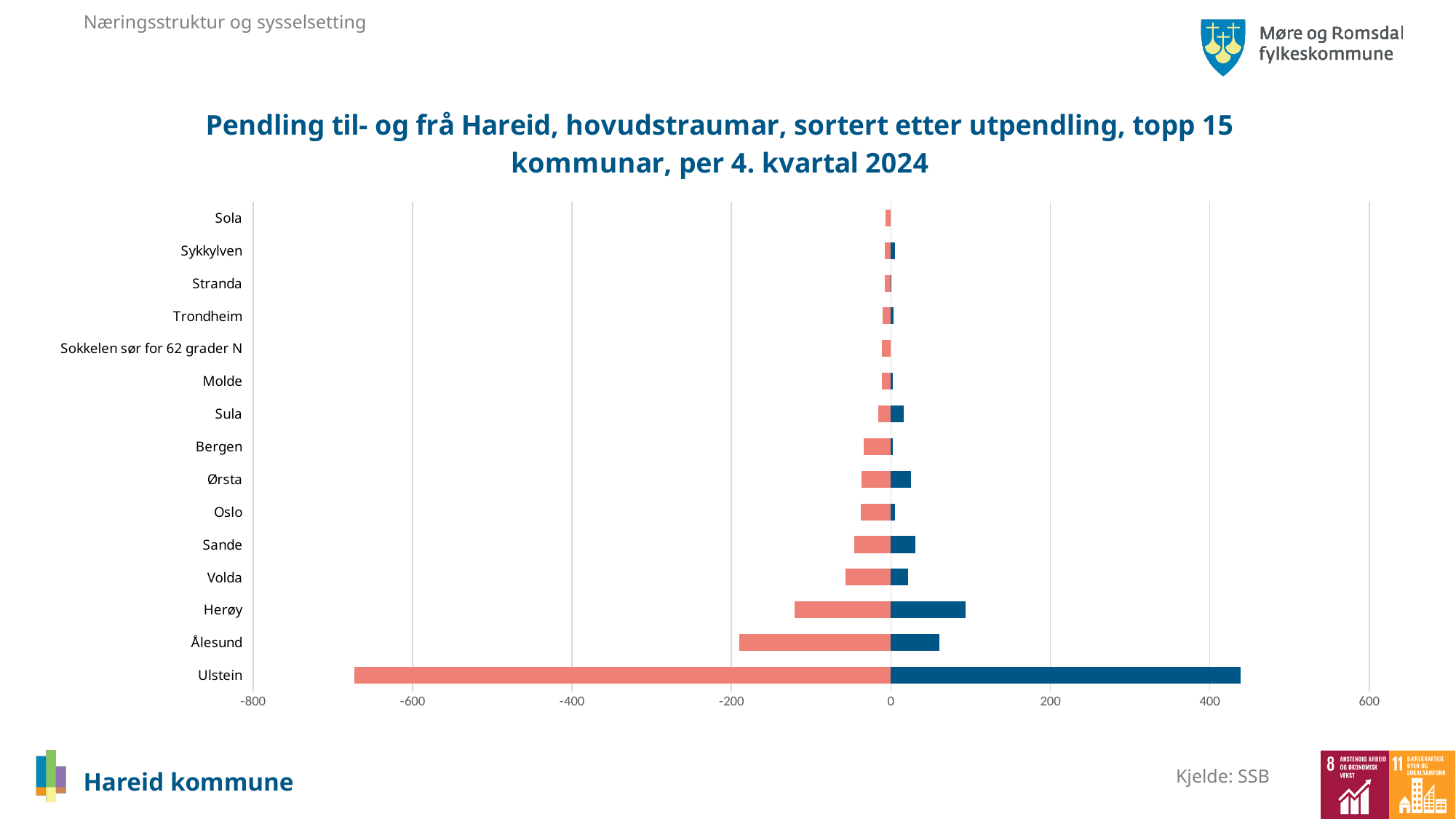
Is the red (negative) value for Herøy greater or less than -200? greater Which has the longer blue (positive) bar, Herøy or Ålesund? Herøy Is the red (negative) value for Ulstein greater or less than -600? less Which municipality has the longest red (negative) bar? Ulstein What is the title of the chart? Pendling til- og frå Hareid, hovudstraumar, sortert etter utpendling, topp 15 kommunar, per 4. kvartal 2024 How many municipalities (categories) are listed on the chart? 15 Which has the longer red (negative) bar, Ålesund or Herøy? Ålesund Going down the list from Sola to Ulstein, do the red bars get longer or shorter? longer Is the blue (positive) value for Ulstein greater or less than 400? greater What kind of chart is shown on the slide? bar chart Which municipality has the longest blue (positive) bar? Ulstein